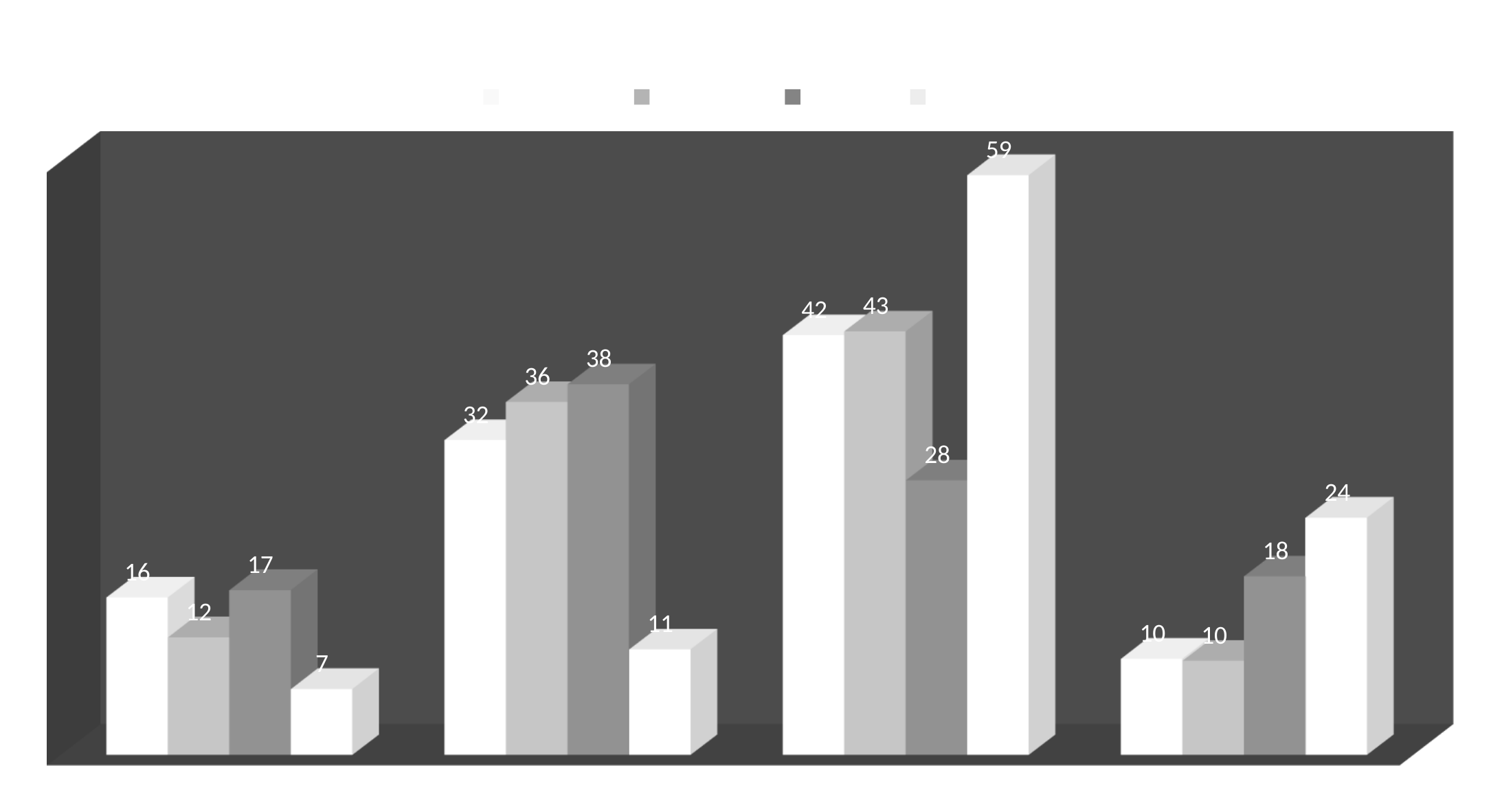
Which is larger: the second bar in the third group or the second bar in the second group? the second bar in the third group (43) What is the lowest value labelled on the chart? 7 What is the difference between the tallest bar in the third group (59) and the third bar in that group (28)? 31 What is the highest value labelled on the chart? 59 What kind of chart is shown on the slide? bar chart What is the value of the third bar in the second group from the left? 38 What is the value of the first bar in the leftmost group? 16 What is the value of the fourth bar in the rightmost group? 24 What is the difference between the first bar in the second group (32) and the first bar in the leftmost group (16)? 16 How many series does the legend list? 4 How many groups of bars are plotted along the x axis? 4 How many bars are in each group? 4